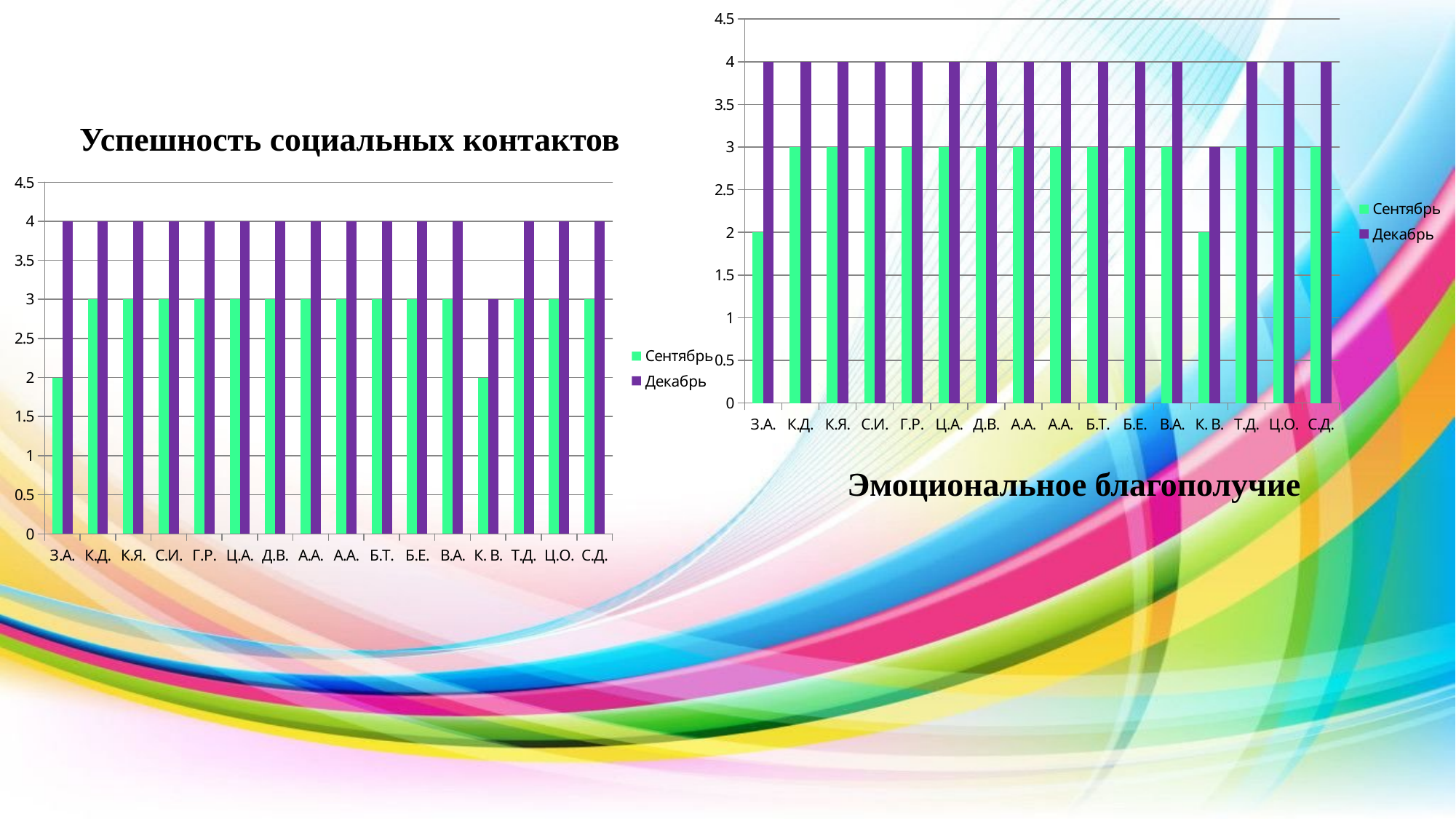
In the chart 'Успешность социальных контактов', how many series does the legend list? 2 In the chart 'Эмоциональное благополучие', which category has the lowest Декабрь value? К.В. In the chart 'Успешность социальных контактов', what is the value for К.В. in the Декабрь series? 3 What kind of chart is 'Успешность социальных контактов'? bar chart In the chart 'Успешность социальных контактов', how many categories are shown on the x axis? 16 In the chart 'Эмоциональное благополучие', is the Сентябрь value for С.Д. greater or less than 2.5? greater In the chart 'Успешность социальных контактов', what is the value for З.А. in the Сентябрь series? 2 In the chart 'Эмоциональное благополучие', what is the value for Т.Д. in the Декабрь series? 4 In the chart 'Эмоциональное благополучие', what is the difference between the Декабрь and Сентябрь values for З.А.? 2 In the chart 'Эмоциональное благополучие', which colour represents the Декабрь series? purple In the chart 'Эмоциональное благополучие', what is the value for К.В. in the Сентябрь series? 2 In the chart 'Успешность социальных контактов', which is larger for К.Д.: the Сентябрь value or the Декабрь value? Декабрь